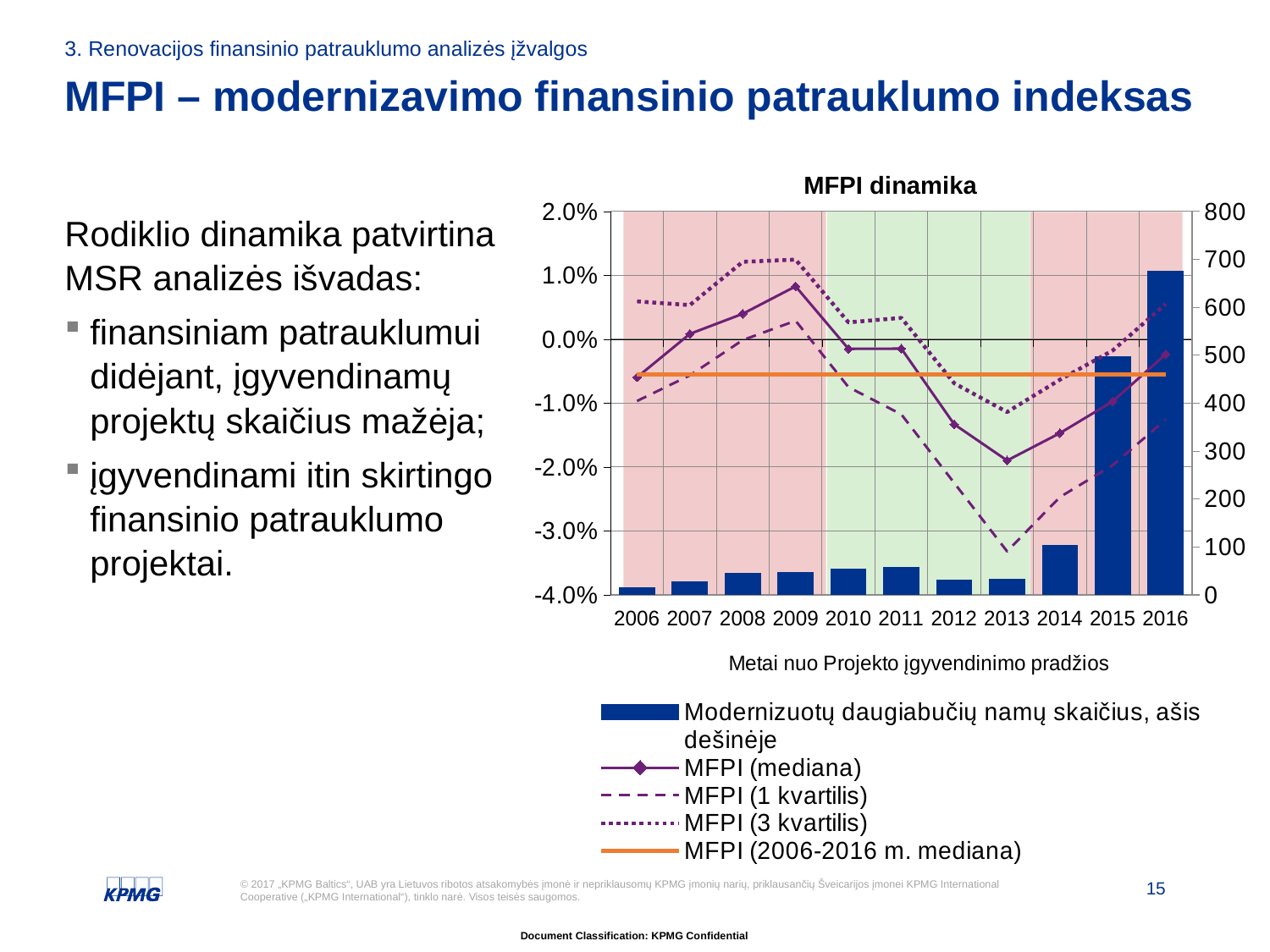
Which year has the lowest MFPI (mediana) value? 2013 Do the bars for Modernizuotų daugiabučių namų skaičius rise or fall from 2013 to 2016? rise What is the title of the chart? MFPI dinamika How many series does the chart legend list? 5 Is the bar value for 2016 (right axis) greater or less than 600? greater Is the MFPI (mediana) value for 2013 greater or less than -1.0%? less Which is larger, the bar for 2015 or the bar for 2014? 2015 Which year has the highest bar for Modernizuotų daugiabučių namų skaičius? 2016 Which year has the lowest bar for Modernizuotų daugiabučių namų skaičius? 2006 How many years are shown on the x axis of the chart? 11 Is the bar value for 2014 (right axis) greater or less than 200? less What kind of chart is shown on the slide? A combined bar and line chart